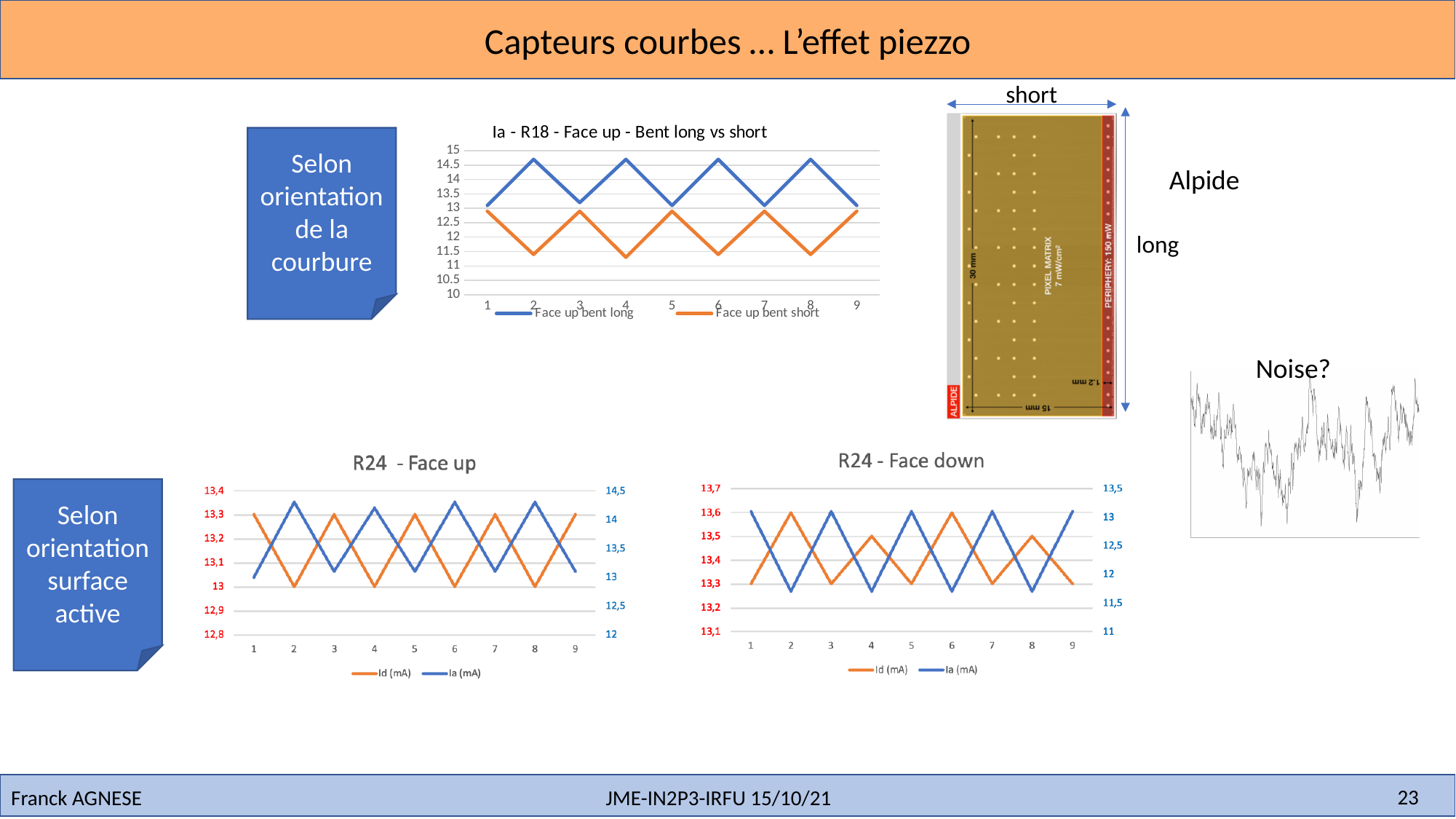
In the 'R24 - Face up' chart, is the value of 'Ia (mA)' at point 2 (right axis) greater or less than 14? greater In the 'R24 - Face down' chart, is the value of 'Ia (mA)' at point 2 (right axis) greater or less than 12? less In the 'R24 - Face down' chart, is the value of 'Id (mA)' at point 2 greater or less than 13.5? greater In the 'Ia - R18 - Face up - Bent long vs short' chart, which series has the higher value at point 4? Face up bent long What are the two legend entries of the 'Ia - R18 - Face up - Bent long vs short' chart? Face up bent long, Face up bent short How many series does the legend of the 'Ia - R18 - Face up - Bent long vs short' chart list? 2 What type of chart is the 'Ia - R18 - Face up - Bent long vs short' chart? line chart How many series does the legend of the 'R24 - Face up' chart list? 2 How many points are plotted along the x axis of the 'Ia - R18 - Face up - Bent long vs short' chart? 9